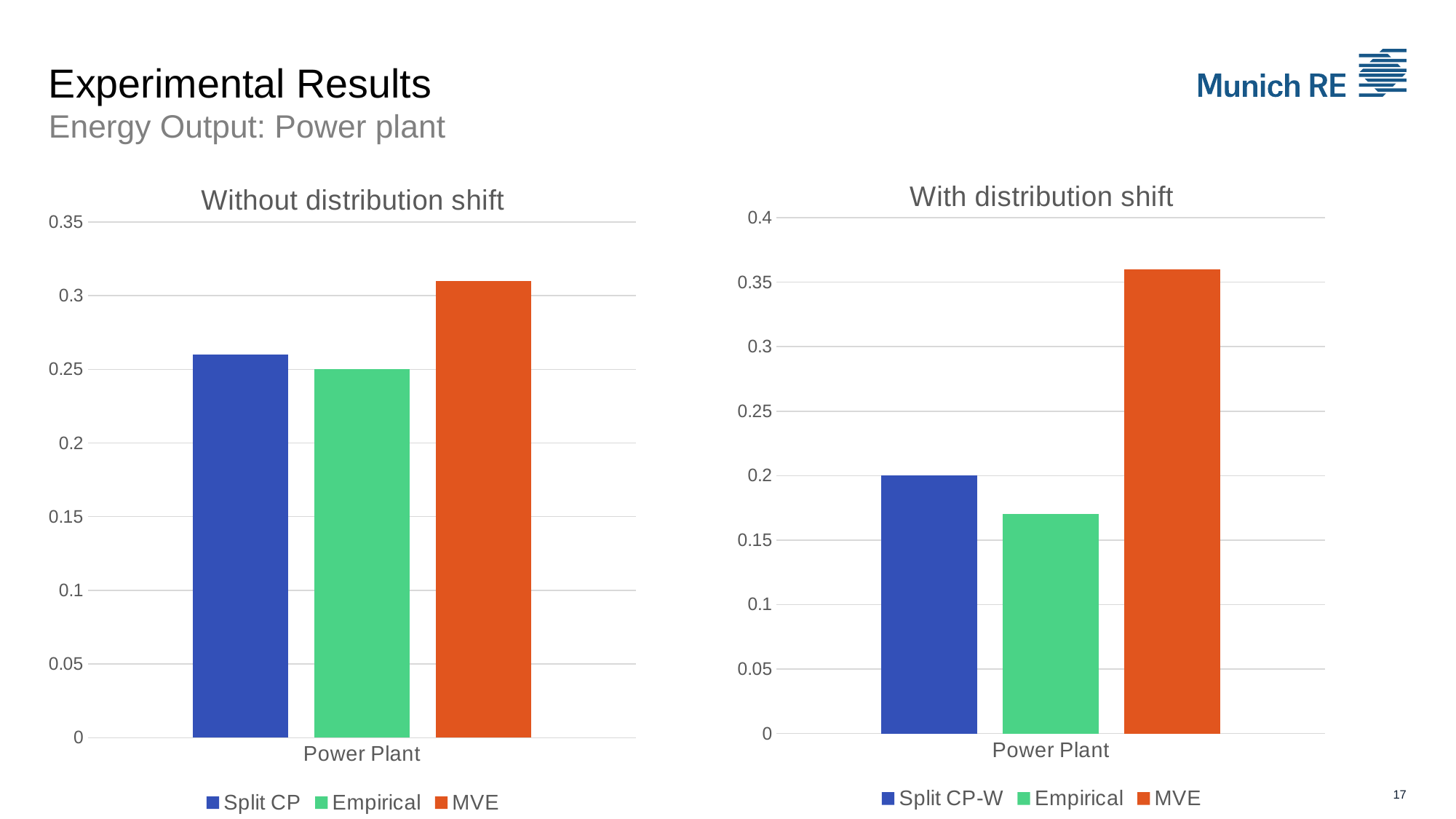
How many series does the legend of the 'Without distribution shift' chart list? 3 In the 'With distribution shift' chart, what is the value for Split CP-W? 0.2 In the 'Without distribution shift' chart, what is the value for Empirical? 0.25 In the 'With distribution shift' chart, which is larger, the value for Split CP-W or the value for MVE? MVE In the 'Without distribution shift' chart, is the value for MVE greater or less than 0.3? greater In the 'Without distribution shift' chart, which series has the highest value? MVE In the 'With distribution shift' chart, which series has the lowest value? Empirical What kind of chart is the 'With distribution shift' chart? Bar chart What is the category label on the x axis of the 'Without distribution shift' chart? Power Plant In the 'With distribution shift' chart, which series has the highest value? MVE In the 'With distribution shift' chart, is the value for Empirical greater or less than 0.2? less In the 'With distribution shift' chart, is the value for MVE greater or less than 0.3? greater